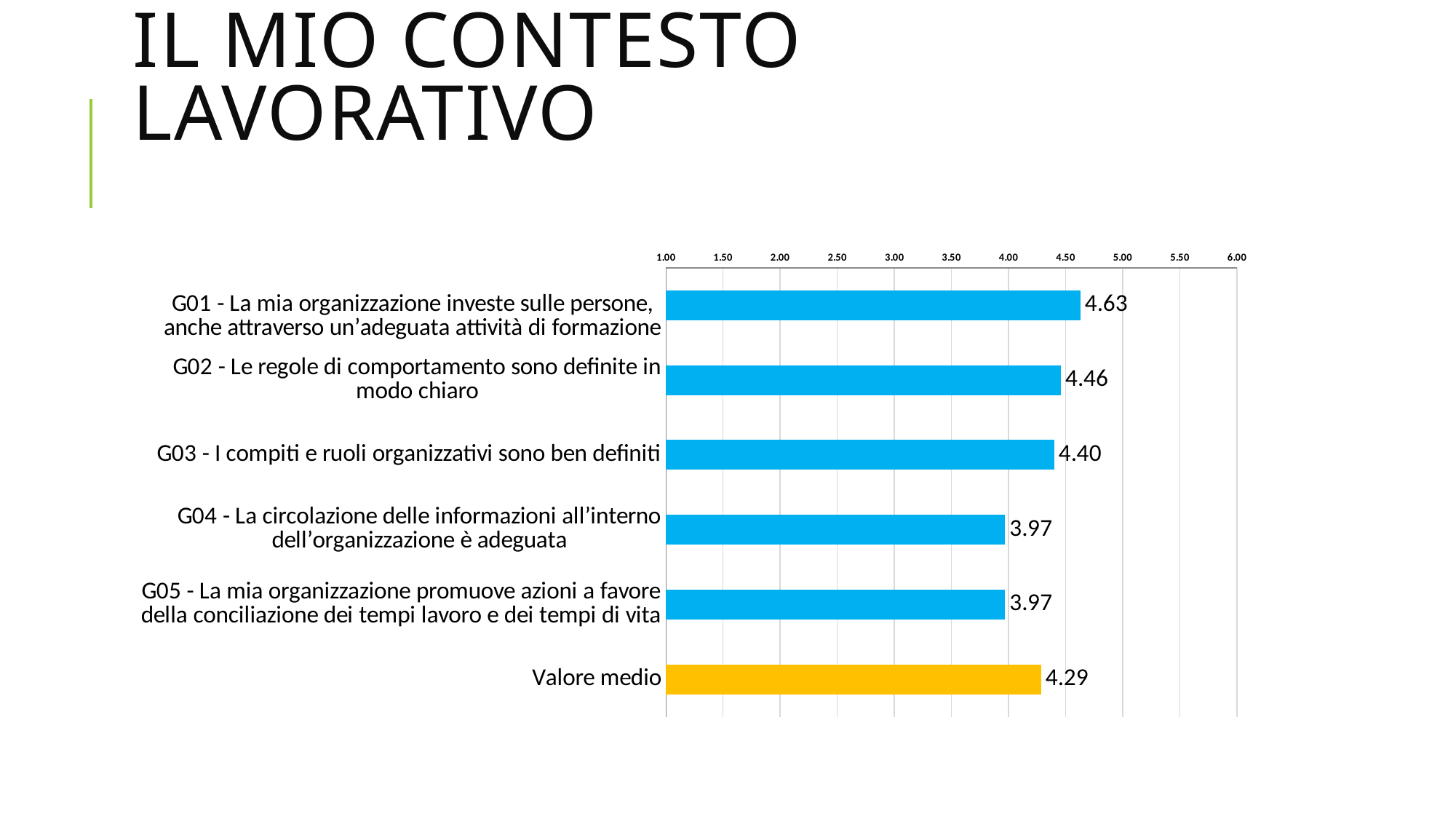
What is the difference between the values for G01 and G02? 0.17 What is the lowest value shown among the G items? 3.97 Which bar is coloured differently (yellow) from the others? Valore medio What is the value for G01 - La mia organizzazione investe sulle persone, anche attraverso un'adeguata attività di formazione? 4.63 What is the value shown for Valore medio? 4.29 Which is larger, the value for G02 or the value for G04? G02 What is the value for G03 - I compiti e ruoli organizzativi sono ben definiti? 4.40 Which item has the highest value? G01 - La mia organizzazione investe sulle persone, anche attraverso un'adeguata attività di formazione What is the difference between the value for G03 and the Valore medio? 0.11 Is the value for G05 greater or less than 4.00? less How many bars are shown in the chart? 6 What kind of chart is shown on the slide? Bar chart